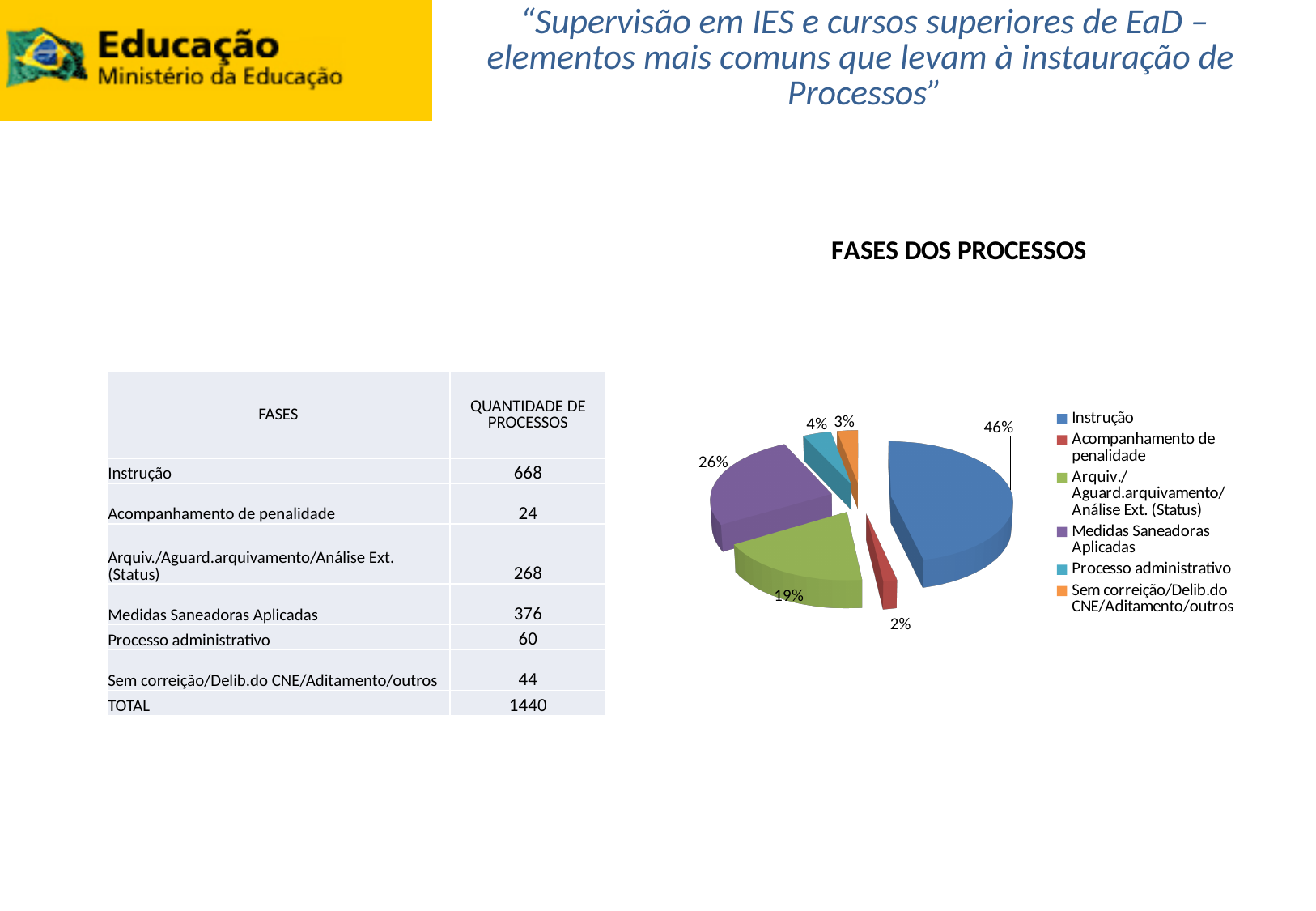
Which category has the smallest slice in the pie chart? Acompanhamento de penalidade Which category has the largest slice in the pie chart? Instrução What is the difference in percentage points between the "Instrução" slice and the "Medidas Saneadoras Aplicadas" slice? 20 percentage points What type of chart is shown under the title "FASES DOS PROCESSOS"? Pie chart What percentage is shown for "Acompanhamento de penalidade" in the pie chart? 2% How many categories does the pie chart legend list? 6 What percentage is shown for "Processo administrativo" in the pie chart? 4% What is the title of the pie chart? FASES DOS PROCESSOS What percentage is shown for "Arquiv./Aguard.arquivamento/Análise Ext. (Status)" in the pie chart? 19% Which slice is larger in the pie chart: "Processo administrativo" or "Sem correição/Delib.do CNE/Aditamento/outros"? Processo administrativo